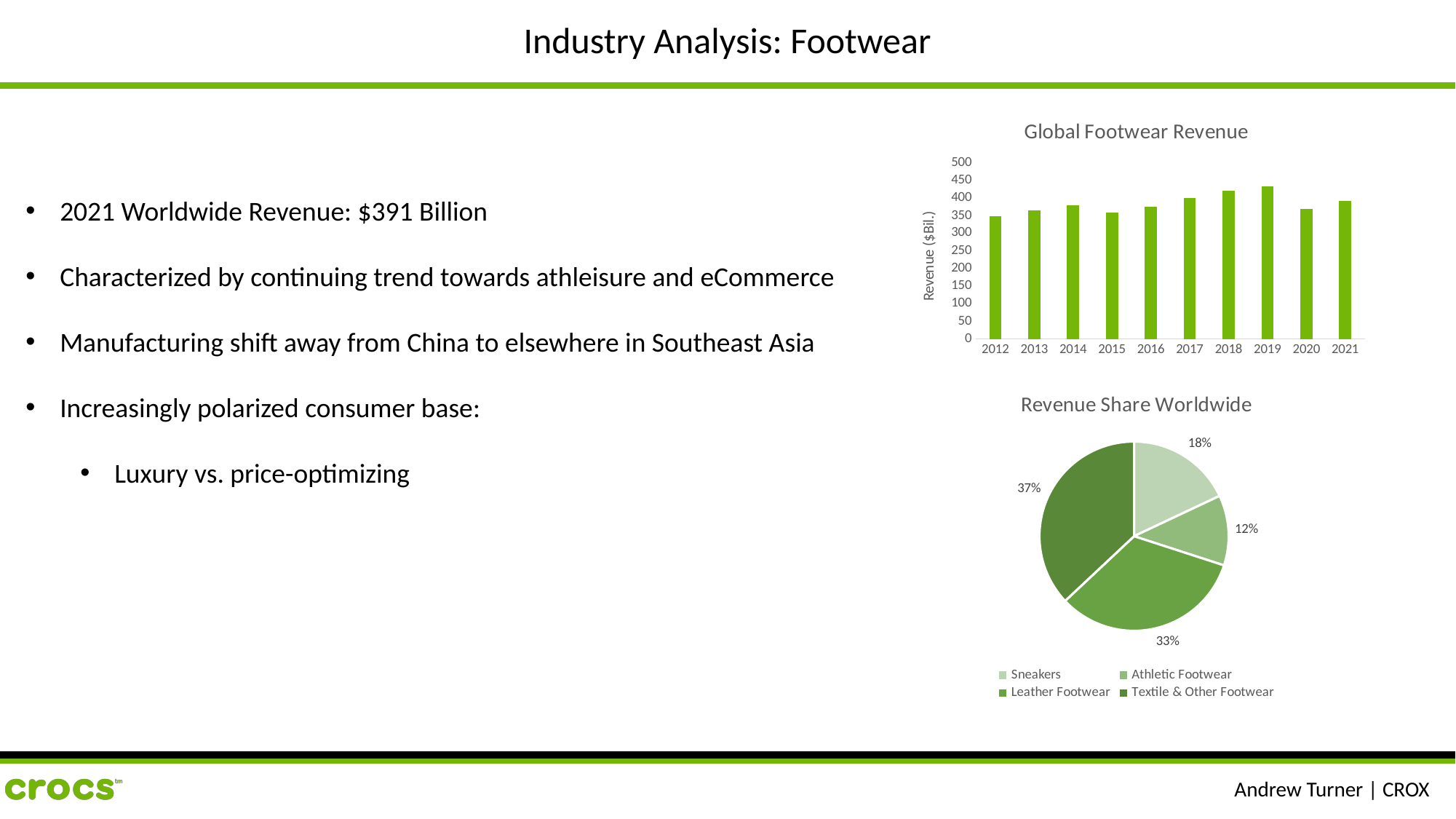
In the Revenue Share Worldwide pie chart, how many categories does the legend list? 4 In the Global Footwear Revenue chart, which year has the highest revenue? 2019 In the Revenue Share Worldwide pie chart, what is the difference between the Textile & Other Footwear share and the Leather Footwear share? 4% In the Global Footwear Revenue chart, is the value for 2019 greater or less than 400? greater In the Revenue Share Worldwide pie chart, what share does Leather Footwear have? 33% In the Revenue Share Worldwide pie chart, which category has the largest share? Textile & Other Footwear In the Revenue Share Worldwide pie chart, which category has the smallest share? Athletic Footwear In the Global Footwear Revenue chart, how many years are shown on the x axis? 10 In the Revenue Share Worldwide pie chart, what share does Sneakers have? 18% In the Global Footwear Revenue chart, is the value for 2013 greater or less than 400? less What kind of chart is the Global Footwear Revenue chart? Bar chart In the Revenue Share Worldwide pie chart, what share does Athletic Footwear have? 12%